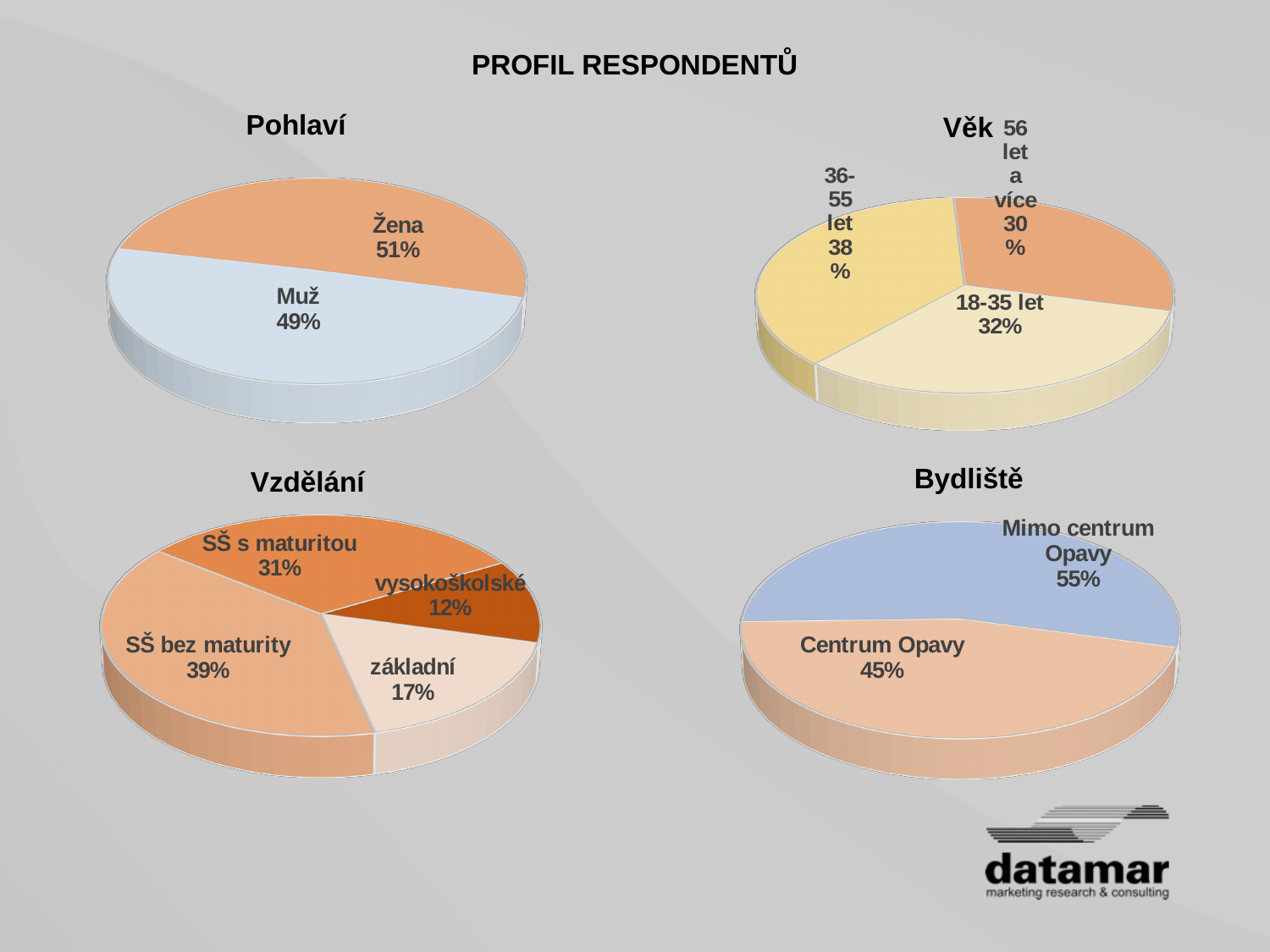
In the 'Pohlaví' chart, what share of respondents are 'Žena'? 51% In the 'Vzdělání' chart, what is the share for 'základní'? 17% In the 'Pohlaví' chart, what share of respondents are 'Muž'? 49% In the 'Bydliště' chart, what is the share for 'Centrum Opavy'? 45% In the 'Věk' chart, which age group has the smallest share? 56 let a více In the 'Vzdělání' chart, what is the difference between 'SŠ bez maturity' and 'SŠ s maturitou'? 8% In the 'Bydliště' chart, which is larger: 'Mimo centrum Opavy' or 'Centrum Opavy'? Mimo centrum Opavy In the 'Vzdělání' chart, which category has the largest share? SŠ bez maturity How many categories does the 'Vzdělání' chart show? 4 In the 'Věk' chart, which age group has the largest share? 36-55 let In the 'Věk' chart, what is the share for '18-35 let'? 32% In the 'Vzdělání' chart, which category has the smallest share? vysokoškolské